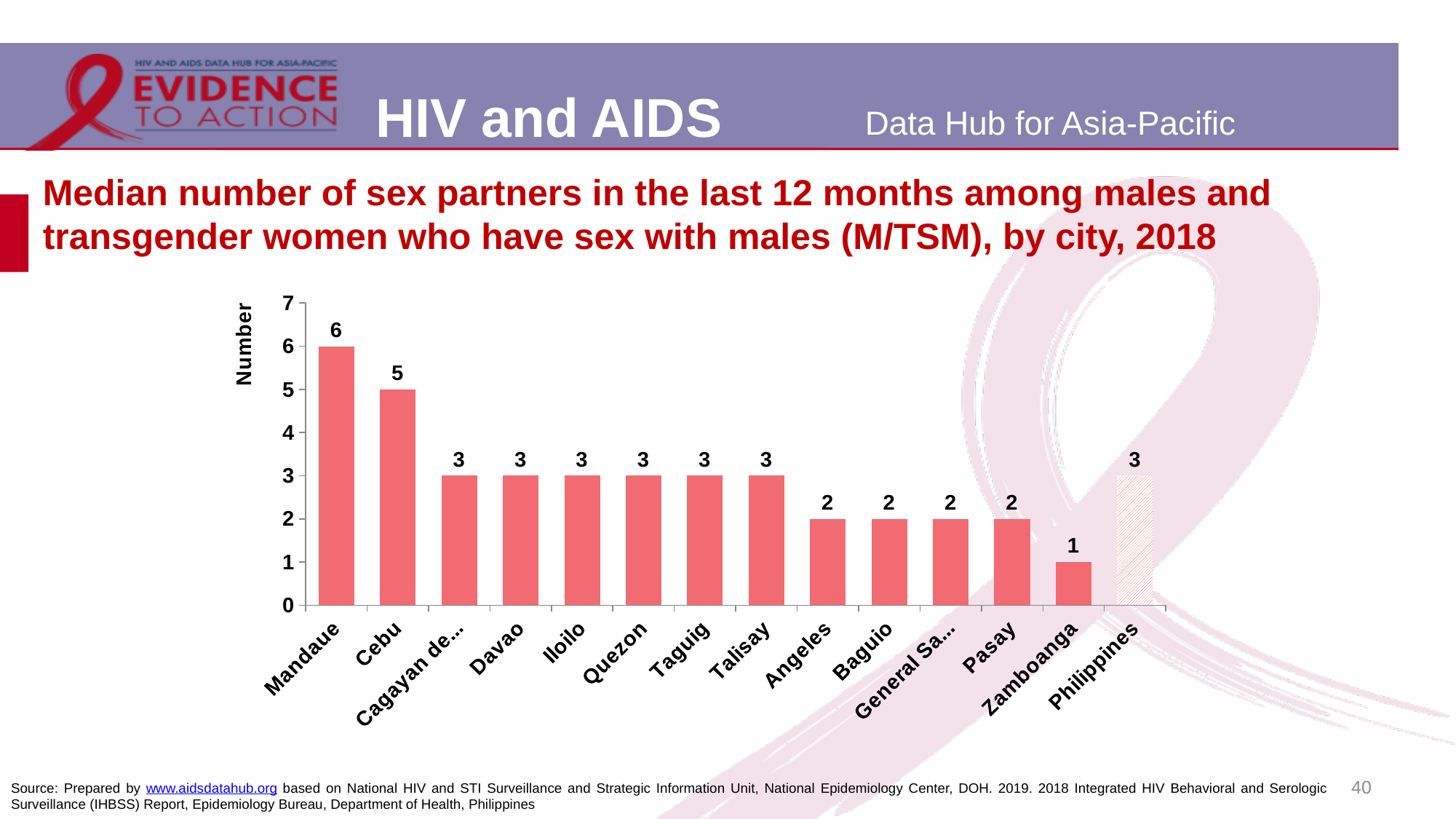
What is the median number of sex partners for Zamboanga? 1 What is the difference between the values for Mandaue and Cebu? 1 What is the value shown for Philippines? 3 What is the difference between the values for Cebu and Zamboanga? 4 Which has a larger value, Davao or Angeles? Davao What is the median number of sex partners for Pasay? 2 Which city has the lowest median number of sex partners? Zamboanga Which city has the highest median number of sex partners? Mandaue What type of chart is shown on the slide? Bar chart What is the median number of sex partners for Cebu? 5 How many bars are shown in the chart? 14 What is the median number of sex partners for Mandaue? 6